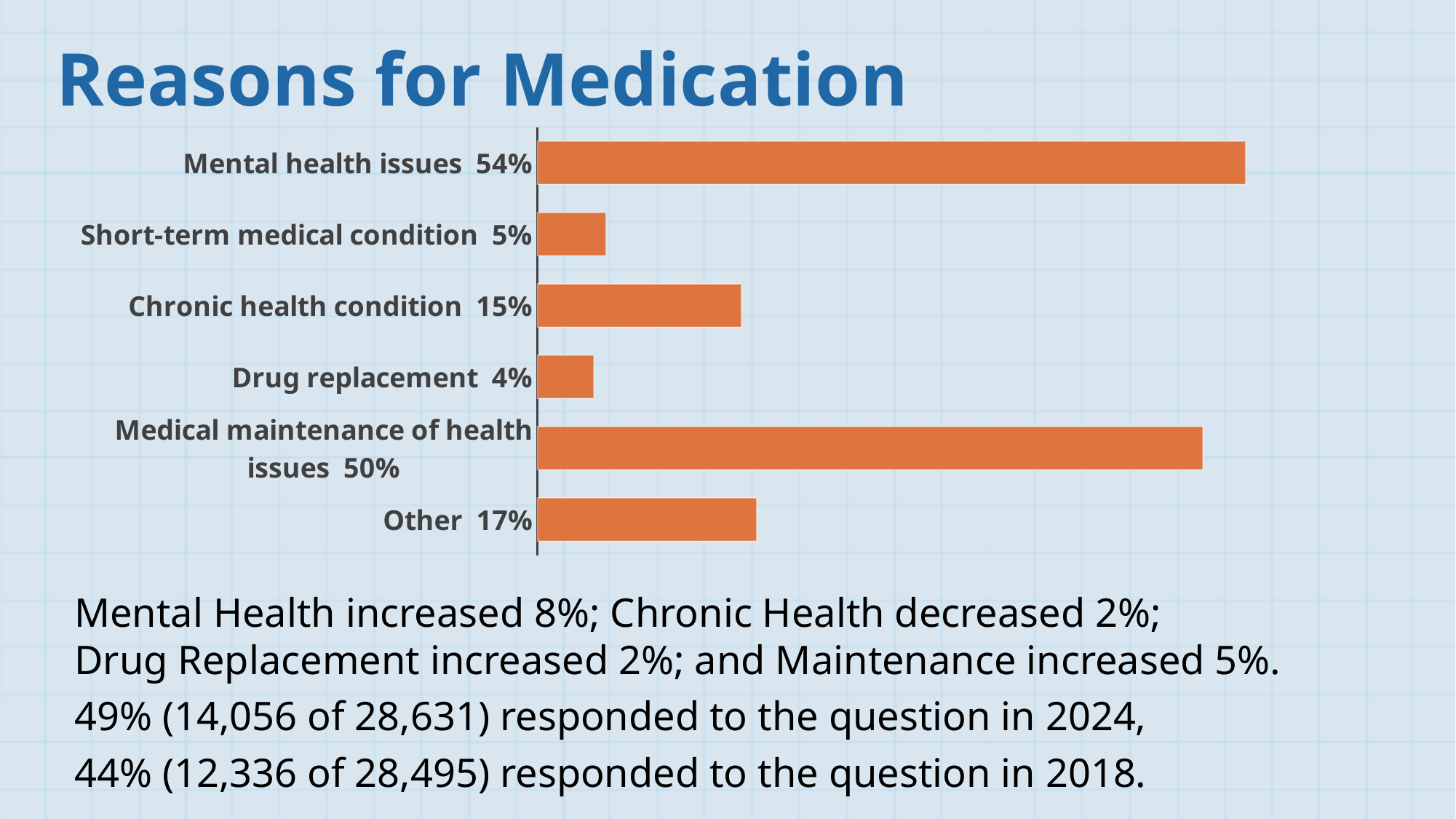
What is the difference between Mental health issues and Medical maintenance of health issues? 4% What is the value for Short-term medical condition? 5% What is the value for Other? 17% Which reason has the lowest value? Drug replacement What is the value for Medical maintenance of health issues? 50% What kind of chart is shown on the slide? Bar chart What is the value for Drug replacement? 4% Which is larger, Chronic health condition or Other? Other What is the value for Mental health issues? 54% How many reasons are shown in the chart? 6 What is the value for Chronic health condition? 15% Which reason has the highest value? Mental health issues